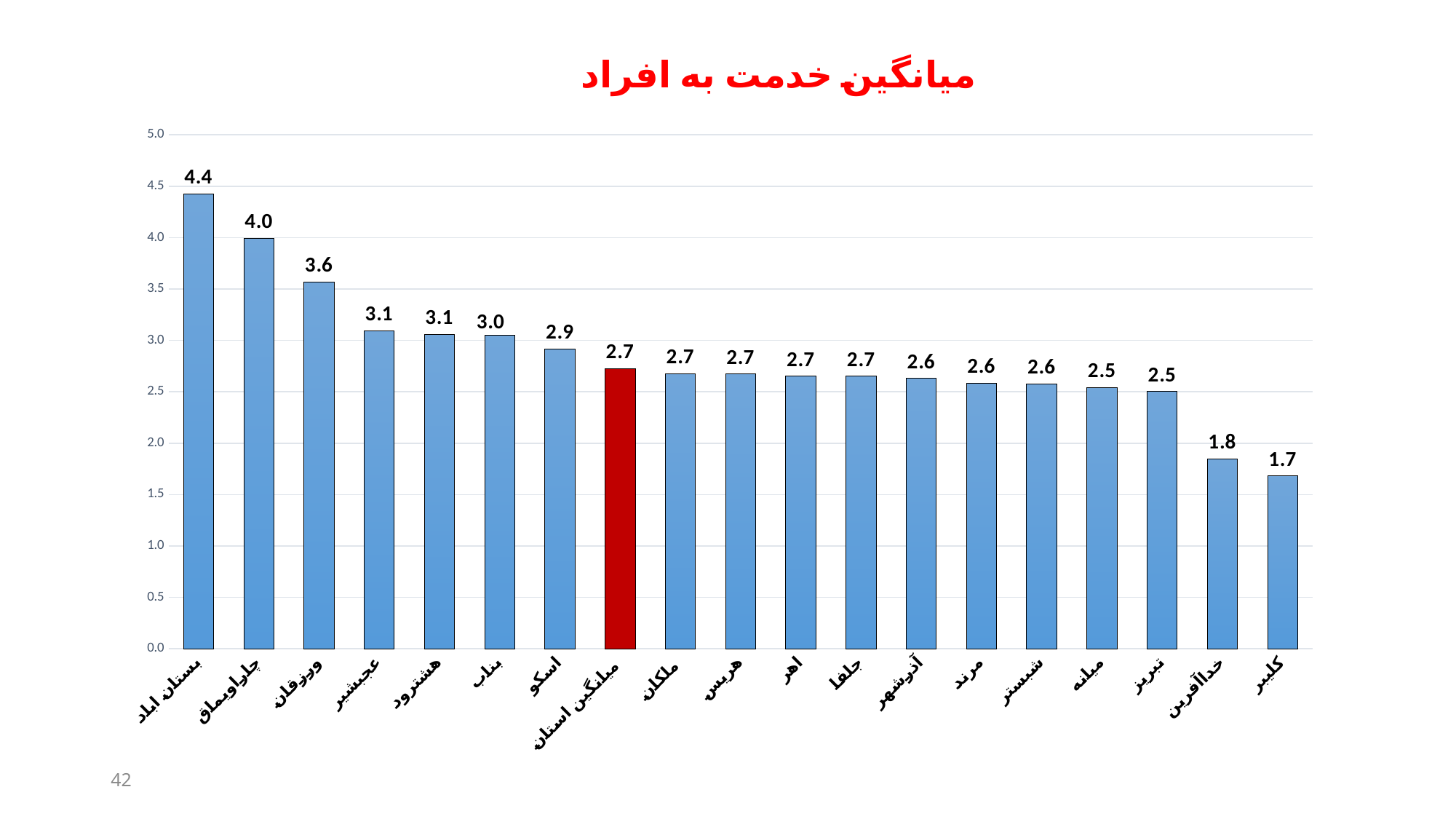
Which category has the lowest value? کلیبر What is the value for کلیبر? 1.7 What kind of chart is shown on the slide? bar chart Which is larger, the value for ورزقان or the value for بناب? ورزقان How many bars are shown in the chart? 19 What is the value for میانگین استان (the red bar)? 2.7 Is the value for خداآفرین greater or less than 2.0? less Which category has the highest value? بستان آباد What is the value for بستان آباد? 4.4 What is the value for تبریز? 2.5 What is the title of the chart? میانگین خدمت به افراد What is the difference between the values for بستان آباد and چاراویماق? 0.4